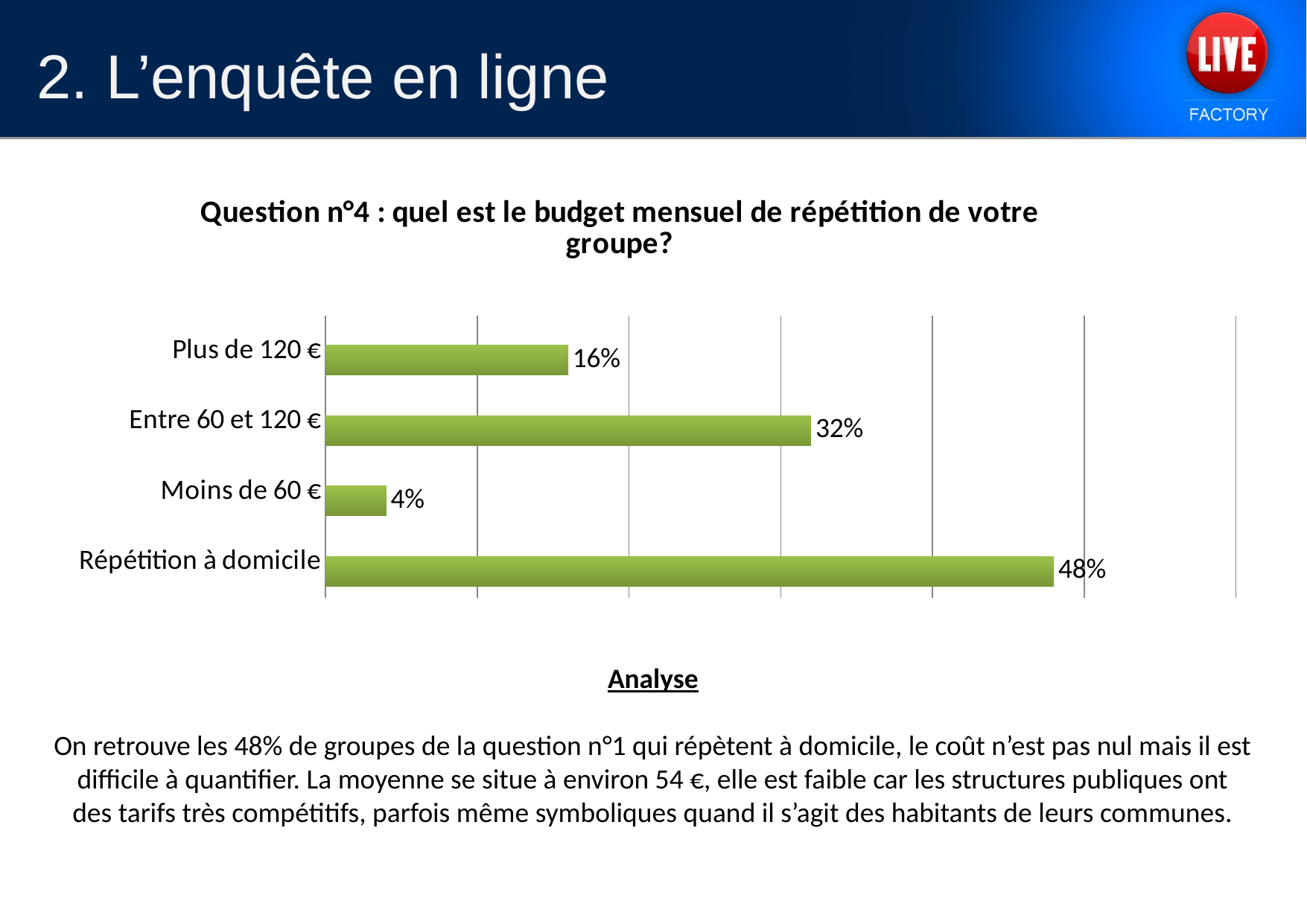
Which is larger, the value for "Plus de 120 €" or the value for "Entre 60 et 120 €"? Entre 60 et 120 € Which category has the highest value? Répétition à domicile What is the difference between the values for "Répétition à domicile" and "Moins de 60 €"? 44% How many categories are shown in the chart? 4 What is the value for "Plus de 120 €"? 16% What is the title of the chart? Question n°4 : quel est le budget mensuel de répétition de votre groupe? What is the difference between the values for "Entre 60 et 120 €" and "Plus de 120 €"? 16% What is the value for "Répétition à domicile"? 48% Which category has the lowest value? Moins de 60 € What is the value for "Entre 60 et 120 €"? 32% What kind of chart is shown on the slide? Bar chart What is the value for "Moins de 60 €"? 4%